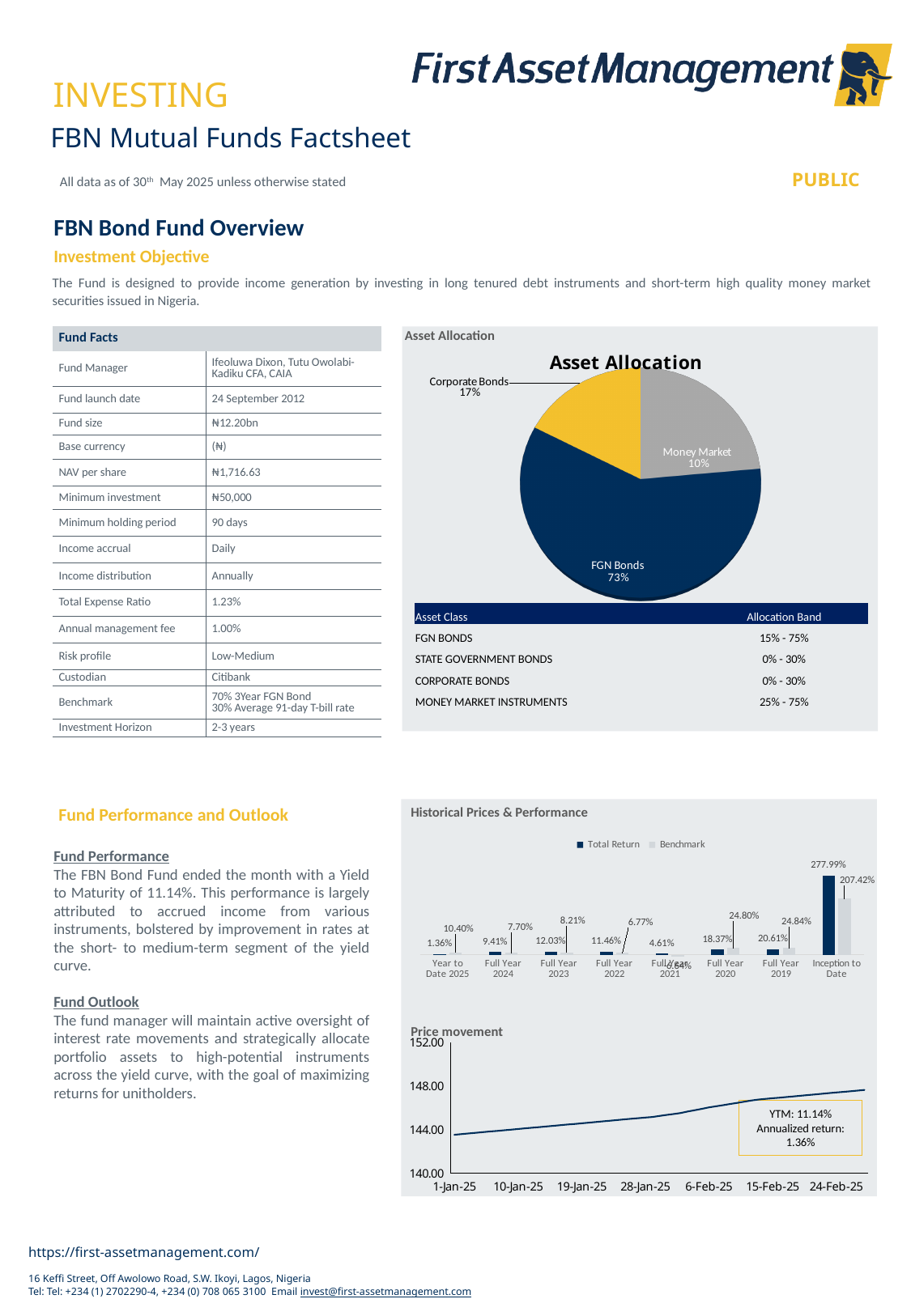
In the Historical Prices & Performance chart, which is larger for Year to Date 2025, Total Return or Benchmark? Benchmark What kind of chart is the Historical Prices & Performance chart? Bar chart In the Historical Prices & Performance chart, what is the Benchmark value for Full Year 2020? 24.80% How many series does the legend of the Historical Prices & Performance chart list? 2 In the Price movement chart, does the price rise or fall from 1-Jan-25 to 24-Feb-25? Rise In the Historical Prices & Performance chart, what is the Total Return for Inception to Date? 277.99% In the Asset Allocation pie chart, what share of the fund is allocated to FGN Bonds? 73% How many slices does the Asset Allocation pie chart have? 3 In the Historical Prices & Performance chart, what is the difference between the Total Return and Benchmark for Full Year 2023? 3.82% In the Price movement chart, is the value at 24-Feb-25 greater or less than 144.00? greater In the Asset Allocation pie chart, what share is allocated to Corporate Bonds? 17%